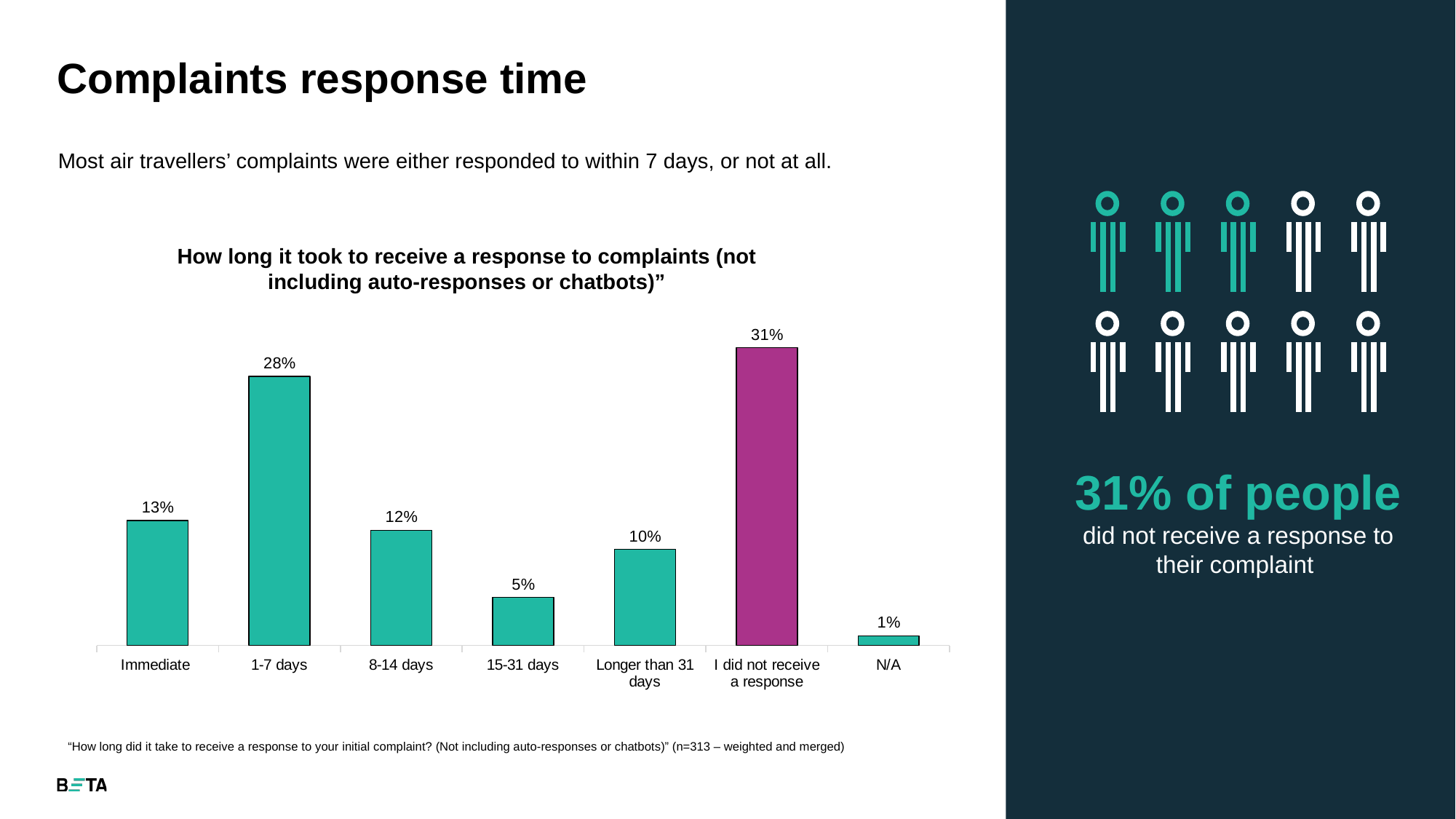
What is the combined value of the 'Immediate' and '1-7 days' categories? 41% What is the difference between the '1-7 days' value and the '8-14 days' value? 16% What percentage of respondents did not receive a response to their complaint? 31% Which category has the lowest value in the chart? N/A Which is larger, the value for '15-31 days' or the value for 'Longer than 31 days'? Longer than 31 days Which bar in the chart is coloured differently (purple) from the others? I did not receive a response What percentage of complaints received an immediate response? 13% What is the value for the 'Longer than 31 days' category? 10% What type of chart is shown on the slide? Bar chart How many categories are shown on the x axis of the chart? 7 What is the value for the '1-7 days' category? 28% Which category has the highest value in the chart? I did not receive a response